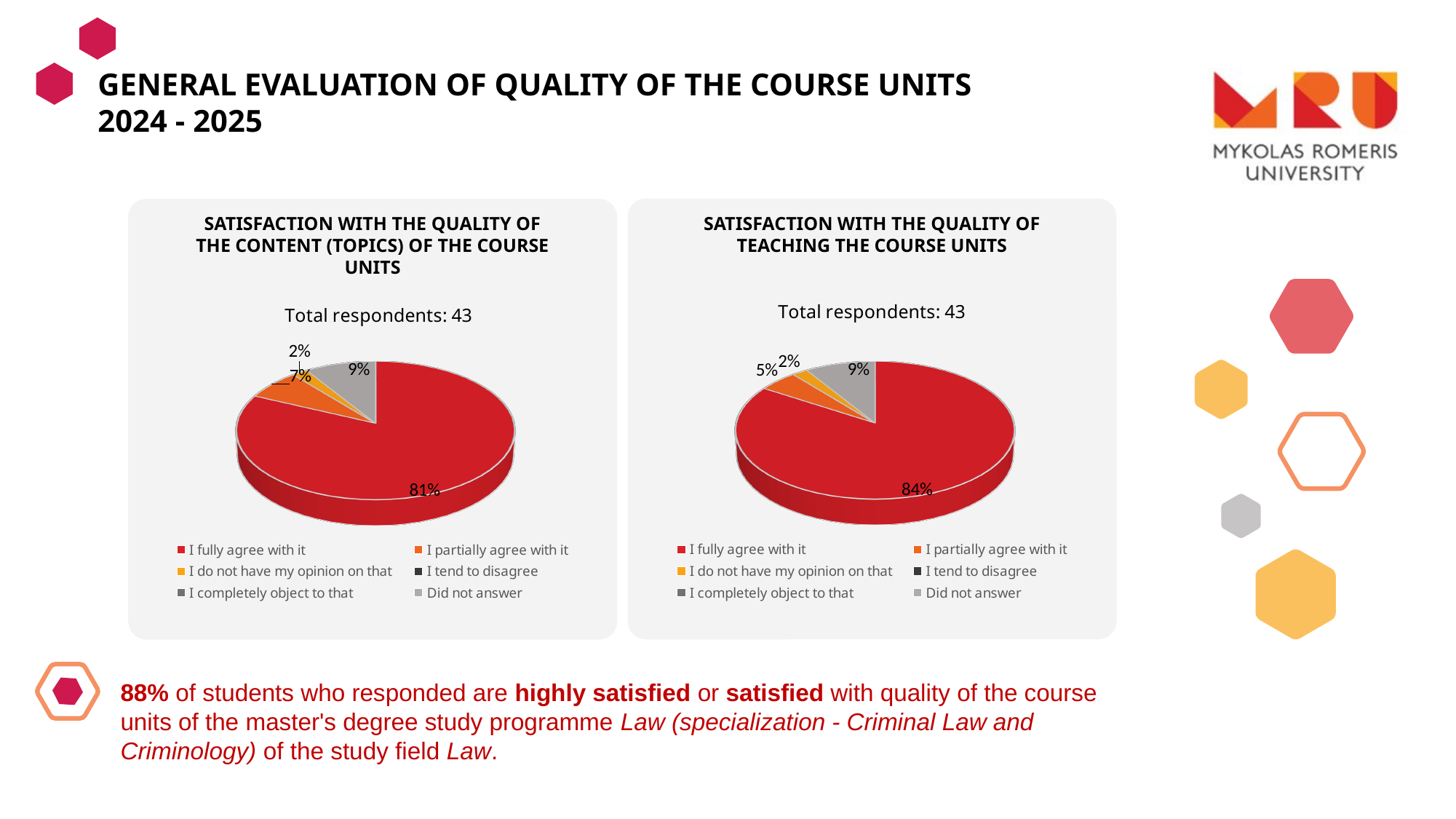
How many entries does the legend of the left chart list? 6 What is the difference between the 'I fully agree with it' share in the teaching chart (84%) and in the content chart (81%)? 3 percentage points In the right chart (teaching the course units), what percentage is shown for 'I do not have my opinion on that'? 2% In the left chart (content of the course units), what percentage of respondents did not answer? 9% What type of chart is used on this slide? Pie chart In the right chart (teaching the course units), what percentage is shown for 'I partially agree with it'? 5% Which chart has the larger 'I partially agree with it' share: the content chart or the teaching chart? The content chart In the left chart (content of the course units), what percentage is shown for 'I partially agree with it'? 7% In the right chart (teaching the course units), which labelled slice is the smallest? I do not have my opinion on that In the left chart (content of the course units), which response category has the largest slice? I fully agree with it In the chart titled 'Satisfaction with the quality of teaching the course units', what share of respondents chose 'I fully agree with it'? 84% In the chart titled 'Satisfaction with the quality of the content (topics) of the course units', what share of respondents chose 'I fully agree with it'? 81%